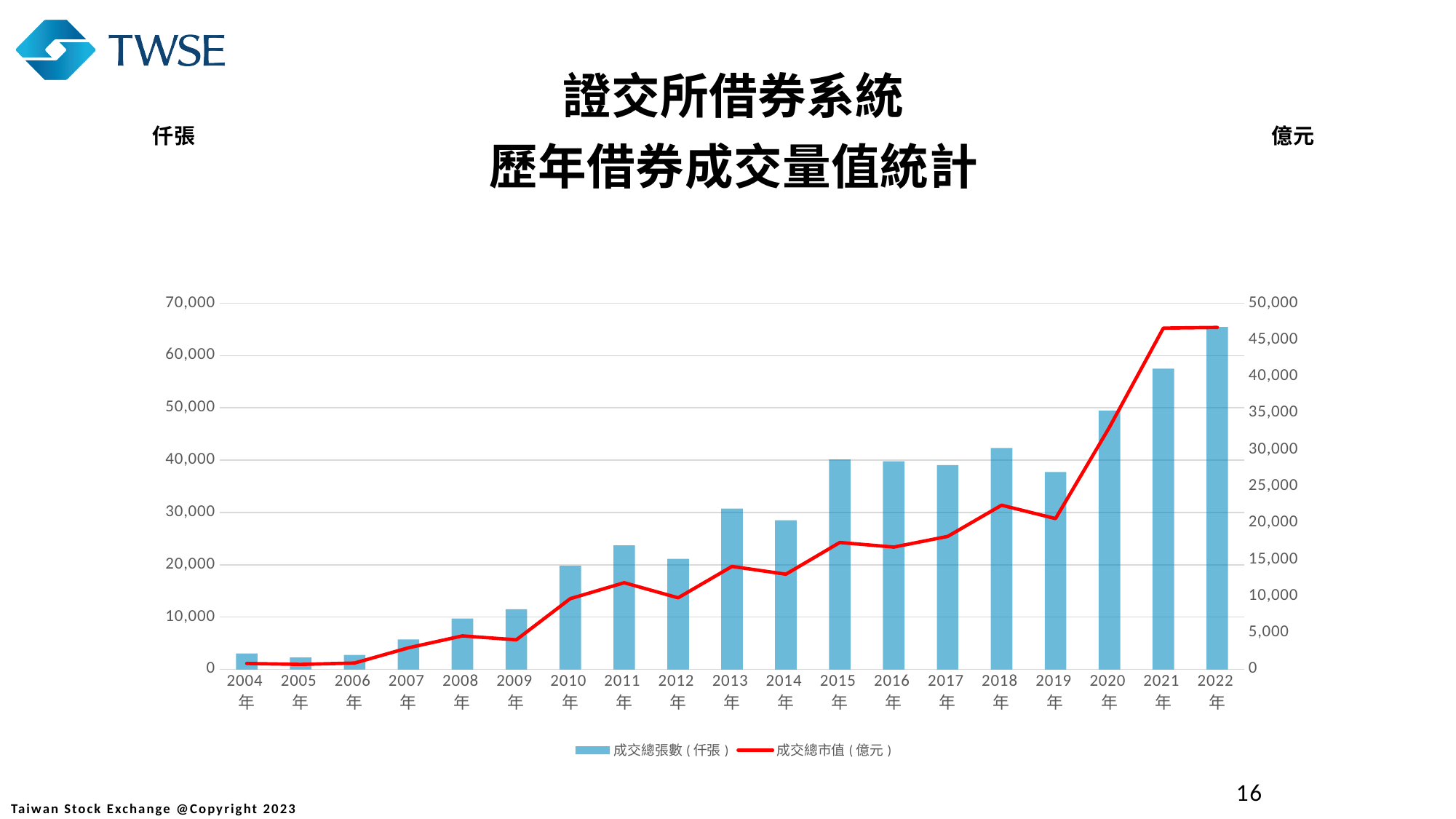
Which year has the shortest bar for 成交總張數 (仟張)? 2005年 Is the 成交總市值 (億元) line value for 2021年 greater or less than 45,000 on the right axis? greater What colour is the line for 成交總市值 (億元)? Red How many series does the chart's legend list? 2 Which year has the tallest bar for 成交總張數 (仟張)? 2022年 Is the 成交總張數 bar for 2019年 greater or less than 40,000? less Overall, does the 成交總市值 (億元) line rise or fall from 2004年 to 2022年? rise Which year has the taller 成交總張數 bar, 2018年 or 2019年? 2018年 How many years are shown along the x axis of the chart? 19 What kind of chart is shown on the slide? A combined bar and line chart Is the 成交總張數 bar for 2021年 greater or less than 50,000? greater